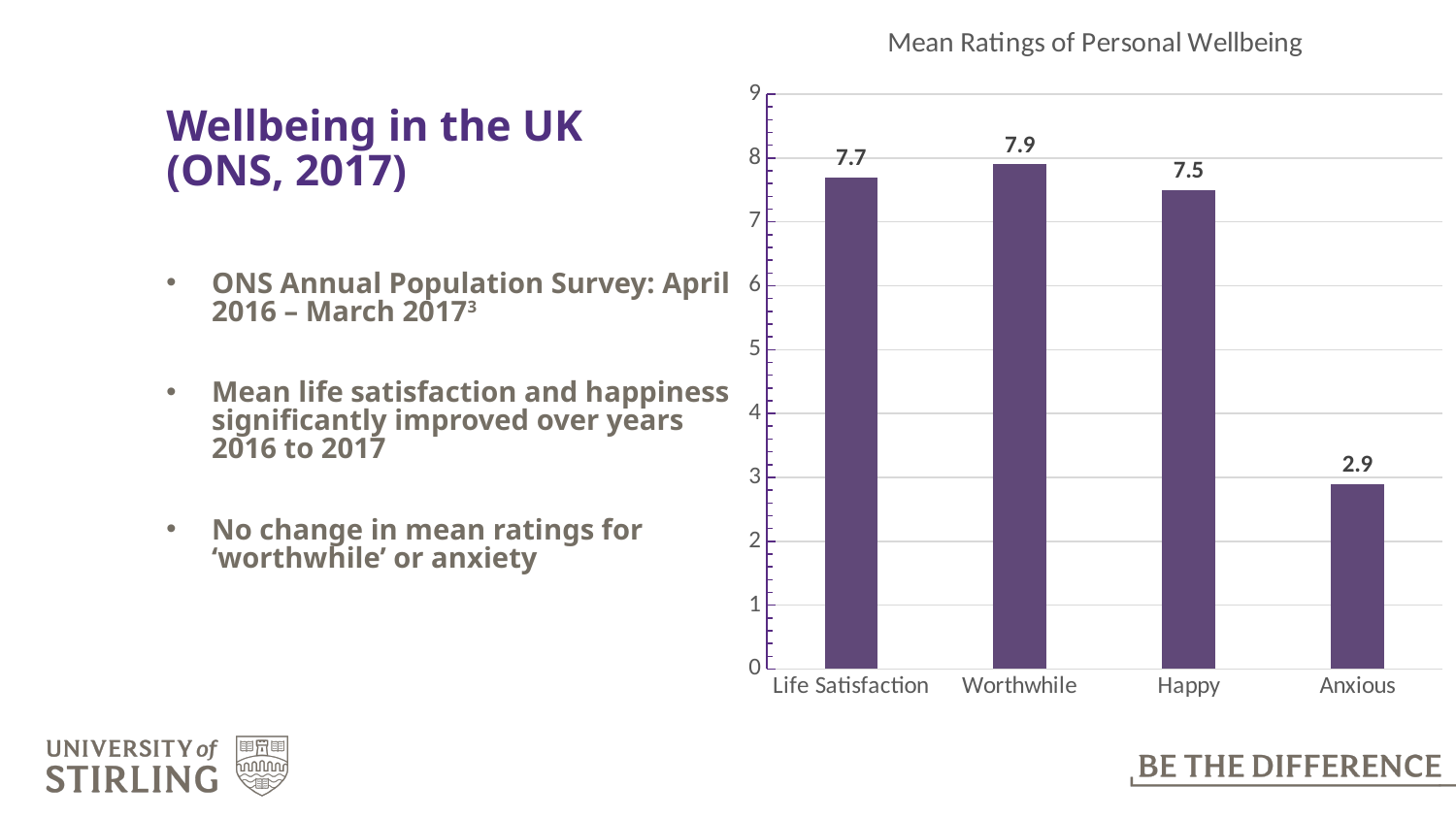
How many categories are shown on the x axis? 4 Which category has the lowest mean rating? Anxious What kind of chart is shown on the slide? Bar chart Which category has the highest mean rating? Worthwhile What is the difference between the mean ratings for Worthwhile and Anxious? 5.0 What is the mean rating for Happy? 7.5 What is the mean rating for Life Satisfaction? 7.7 What is the title of the chart? Mean Ratings of Personal Wellbeing What is the mean rating for Worthwhile? 7.9 What is the mean rating for Anxious? 2.9 Which is larger, the mean rating for Happy or for Anxious? Happy What is the difference between the mean ratings for Life Satisfaction and Happy? 0.2